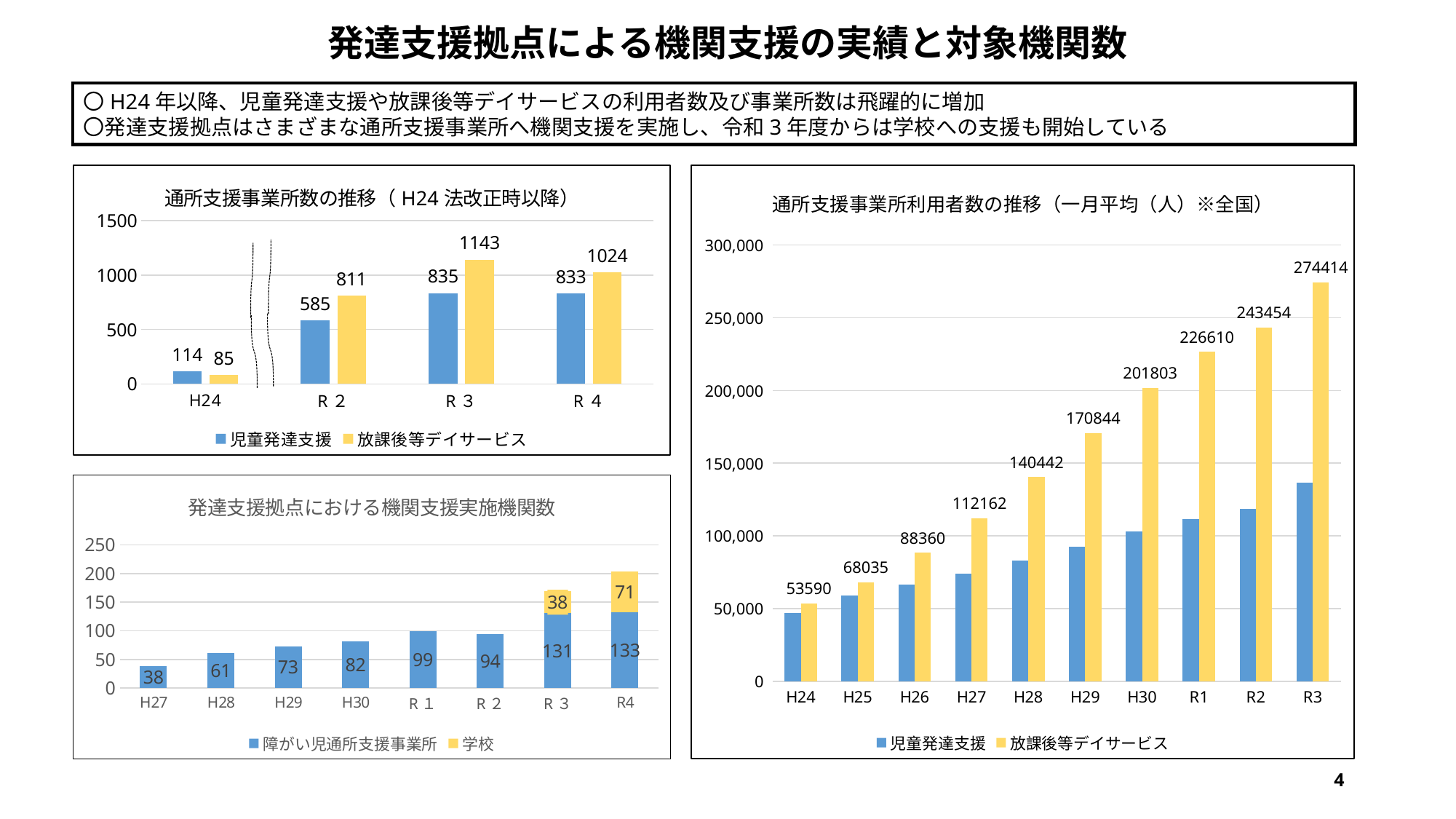
In the chart titled 発達支援拠点における機関支援実施機関数, which category has the lowest value for 障がい児通所支援事業所? H27 In the chart titled 通所支援事業所数の推移（H24法改正時以降）, what is the difference between 放課後等デイサービス and 児童発達支援 in R2? 226 In the chart titled 通所支援事業所利用者数の推移（一月平均（人）※全国）, is the value for 児童発達支援 in R3 greater or less than 150,000? less In the chart titled 発達支援拠点における機関支援実施機関数, what is the total of the stacked bar for R3? 169 In the chart titled 通所支援事業所利用者数の推移（一月平均（人）※全国）, do the values for 放課後等デイサービス rise or fall from H24 to R3? rise In the chart titled 通所支援事業所利用者数の推移（一月平均（人）※全国）, how many series does the legend list? 2 In the chart titled 通所支援事業所数の推移（H24法改正時以降）, which category has the highest value for 放課後等デイサービス? R3 In the chart titled 通所支援事業所利用者数の推移（一月平均（人）※全国）, what is the value for 放課後等デイサービス in H30? 201803 In the chart titled 発達支援拠点における機関支援実施機関数, what is the value for 学校 in R4? 71 In the chart titled 通所支援事業所数の推移（H24法改正時以降）, what is the value for 放課後等デイサービス in R3? 1143 In the chart titled 発達支援拠点における機関支援実施機関数, how many categories are shown on the x axis? 8 In the chart titled 通所支援事業所数の推移（H24法改正時以降）, what is the value for 児童発達支援 in H24? 114